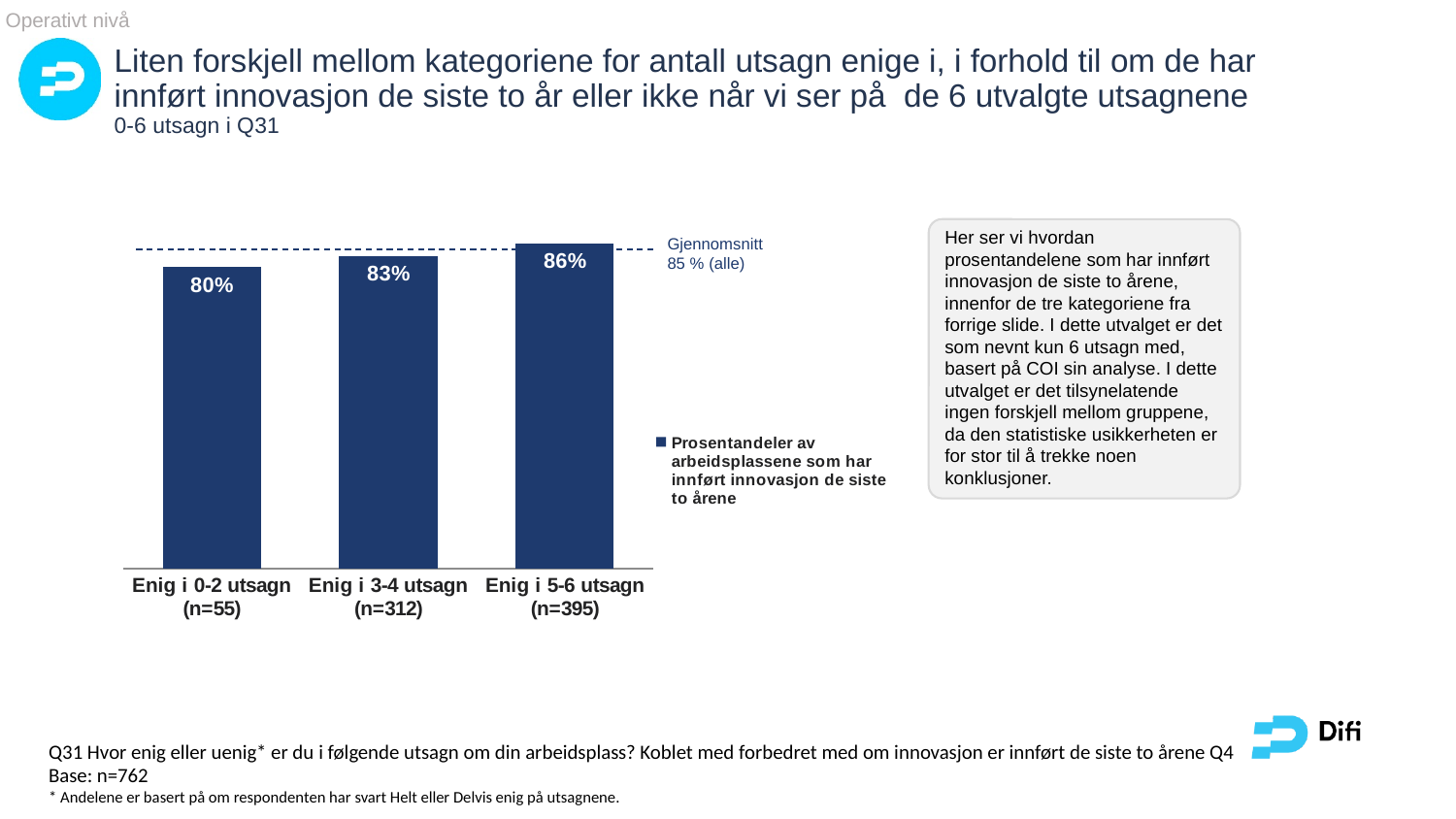
What is the value for "Enig i 3-4 utsagn (n=312)"? 83% Do the values rise or fall from left to right along the x axis? Rise What is the difference between the values for "Enig i 3-4 utsagn" and "Enig i 0-2 utsagn"? 3% What is the value for "Enig i 5-6 utsagn (n=395)"? 86% How many series does the legend list? 1 What is the value for "Enig i 0-2 utsagn (n=55)"? 80% Which category has the lowest value? Enig i 0-2 utsagn (n=55) What is the difference between the values for "Enig i 5-6 utsagn" and "Enig i 0-2 utsagn"? 6% Which category has the highest value? Enig i 5-6 utsagn (n=395) How many categories are shown on the x axis? 3 Which is larger, the value for "Enig i 3-4 utsagn" or "Enig i 5-6 utsagn"? Enig i 5-6 utsagn What kind of chart is shown? Bar chart